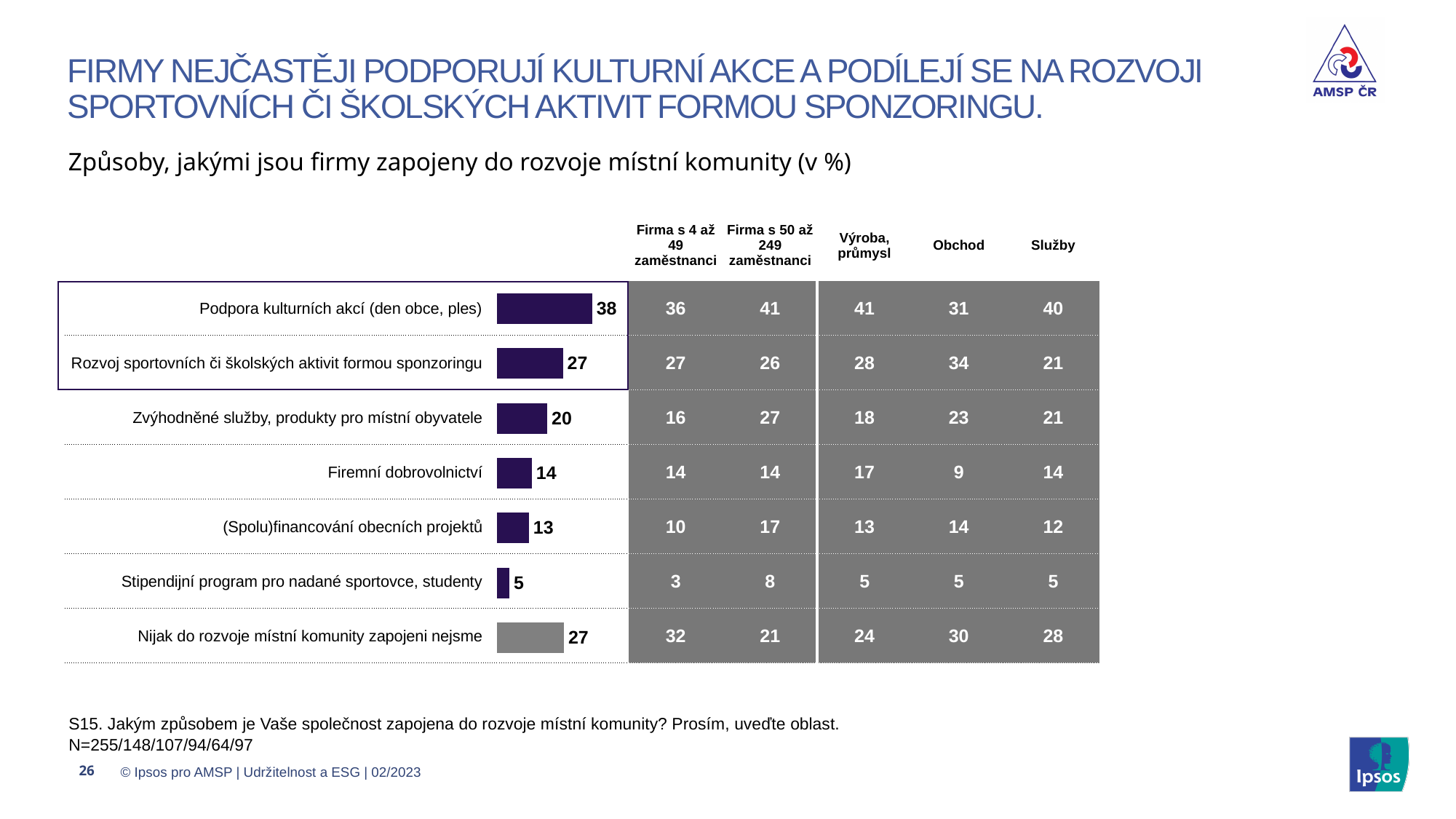
Which category has the highest value in the bar chart? Podpora kulturních akcí (den obce, ples) Which category has the lowest value in the bar chart? Stipendijní program pro nadané sportovce, studenty What kind of chart is shown on the slide? bar chart In the table, what is the value for 'Rozvoj sportovních či školských aktivit formou sponzoringu' in the 'Obchod' column? 34 What is the difference between the values for 'Podpora kulturních akcí (den obce, ples)' and 'Rozvoj sportovních či školských aktivit formou sponzoringu'? 11 What is the value for 'Firemní dobrovolnictví' in the bar chart? 14 Which category's bar is coloured grey instead of dark purple? Nijak do rozvoje místní komunity zapojeni nejsme What is the value for 'Podpora kulturních akcí (den obce, ples)' in the bar chart? 38 How many categories are shown in the bar chart? 7 Which is larger: the value for 'Zvýhodněné služby, produkty pro místní obyvatele' or for '(Spolu)financování obecních projektů'? Zvýhodněné služby, produkty pro místní obyvatele What is the difference between the values for 'Zvýhodněné služby, produkty pro místní obyvatele' and 'Firemní dobrovolnictví'? 6 What is the value for 'Stipendijní program pro nadané sportovce, studenty' in the bar chart? 5